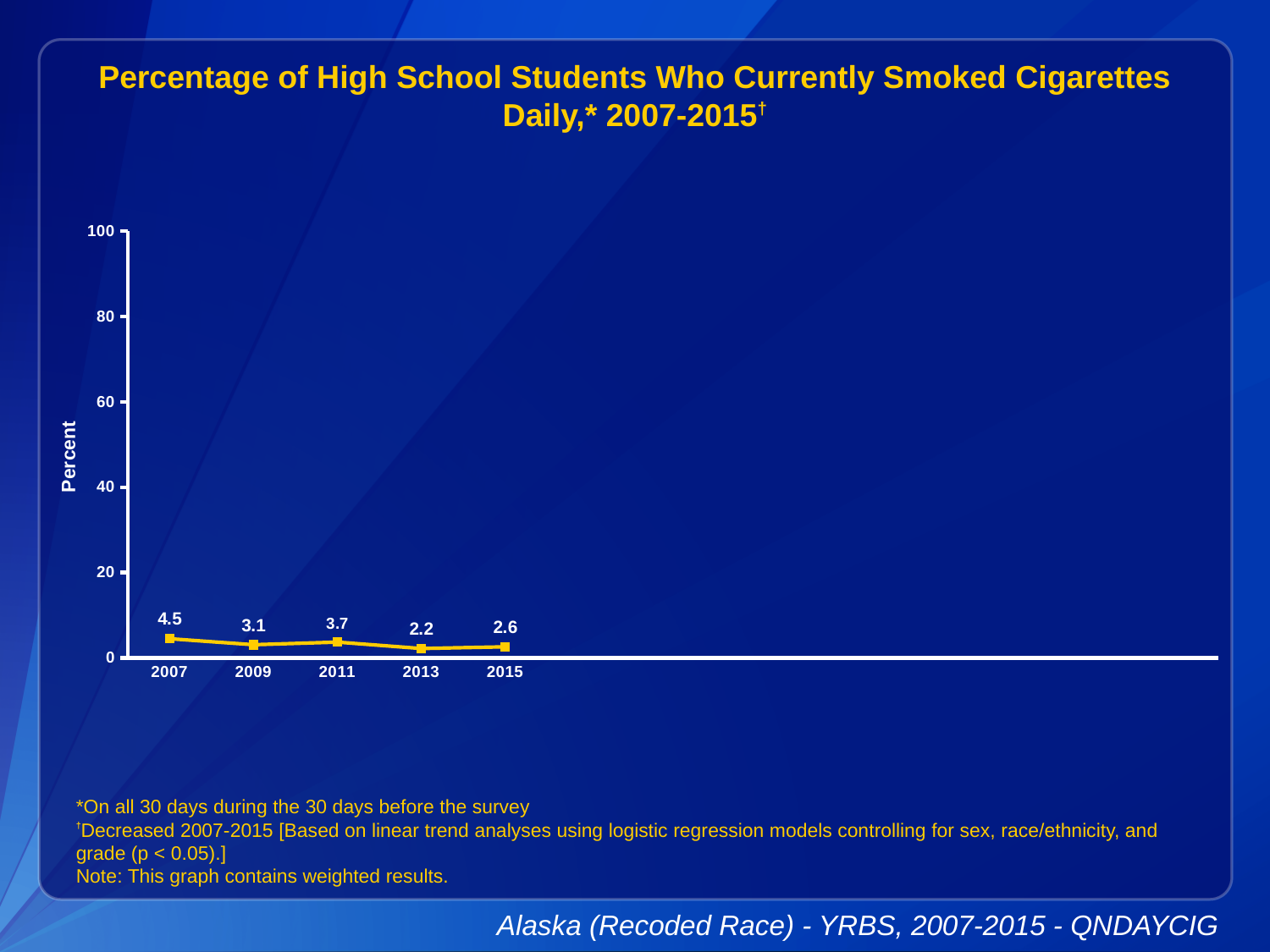
What was the percentage of high school students who currently smoked cigarettes daily in 2007? 4.5 Which is larger, the value for 2009 or the value for 2011? 2011 What kind of chart is shown on the slide? line chart What value is shown for 2013? 2.2 What is the difference between the 2007 value and the 2015 value? 1.9 How many years are plotted on the chart? 5 Which year has the lowest value? 2013 What is the label on the y axis? Percent What value is shown for 2015? 2.6 Which year has the highest value? 2007 Overall, do the values rise or fall from 2007 to 2015? fall Is the value for 2007 greater or less than 20? less